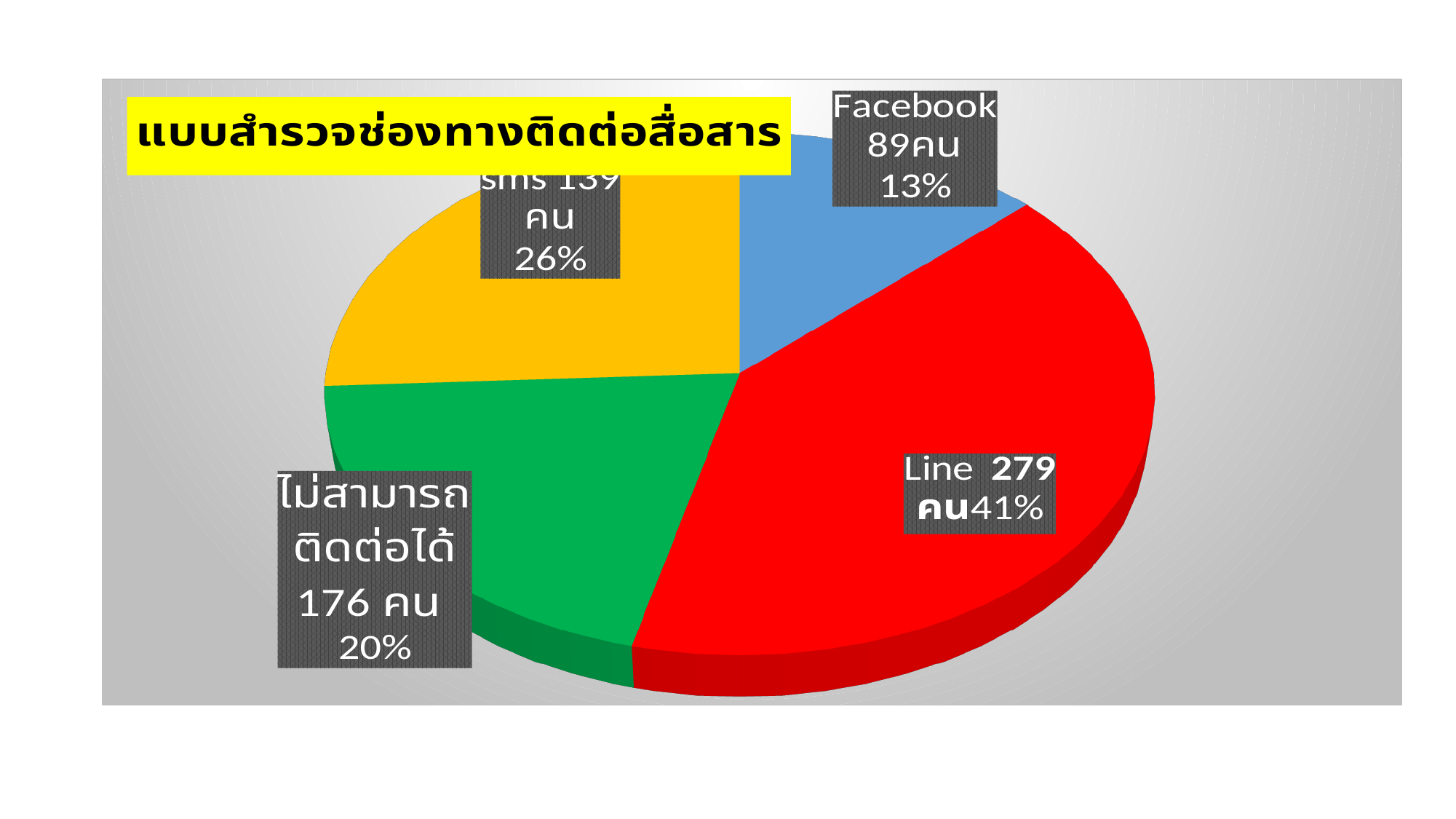
How many people chose Line as their communication channel? 279 คน Which category has the smallest slice of the pie? Facebook Which category has the largest slice of the pie? Line What is the difference in number of people between Line and Facebook? 190 What percentage of the pie does the Facebook slice represent? 13% What kind of chart is shown on the slide? pie chart Which has more people, sms or ไม่สามารถติดต่อได้? ไม่สามารถติดต่อได้ What percentage share does the sms slice have? 26% What percentage share does the Line slice have? 41% What colour is the Line slice of the pie? red How many people are in the ไม่สามารถติดต่อได้ category? 176 คน How many slices does the pie chart have? 4